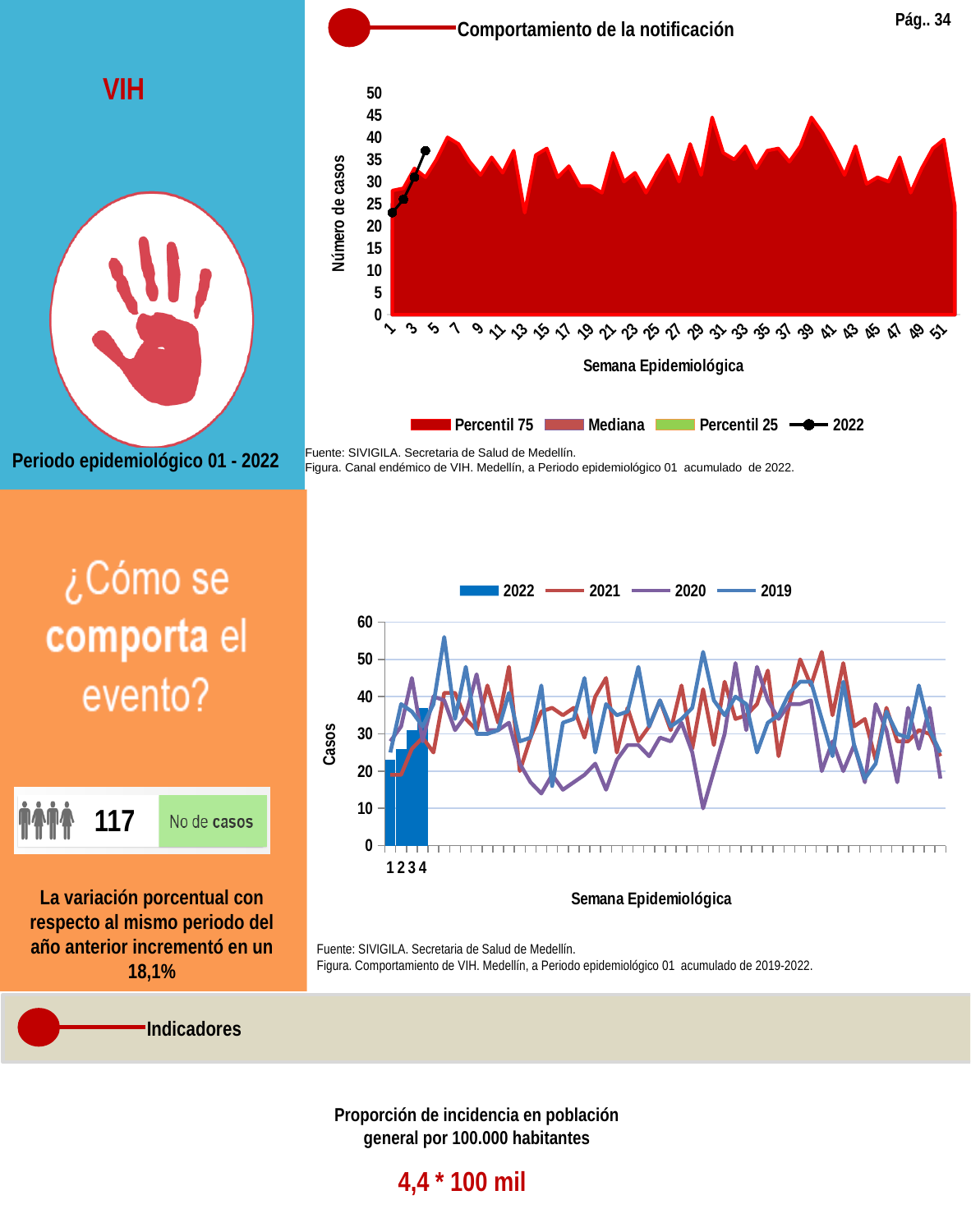
In the bottom chart, which week has the lowest 2022 bar? 1 In the bottom chart, which series is drawn as bars rather than lines? 2022 In the top chart (Comportamiento de la notificación), how many series does the legend list? 4 In the bottom chart, which week has the highest 2022 bar? 4 In the bottom chart, how many bars are plotted for 2022? 4 In the top chart, does the 2022 line rise or fall from week 1 to week 4? rise In the bottom chart, is the 2022 bar for week 4 greater or less than 30? greater In the top chart, what is the label of the vertical axis? Número de casos In the bottom chart, how many series does the legend list? 4 In the top chart, is the 2022 value at week 1 greater or less than 30? less In the top chart, is the 2022 value at week 4 greater or less than 30? greater In the top chart, how many points are plotted for the 2022 series? 4